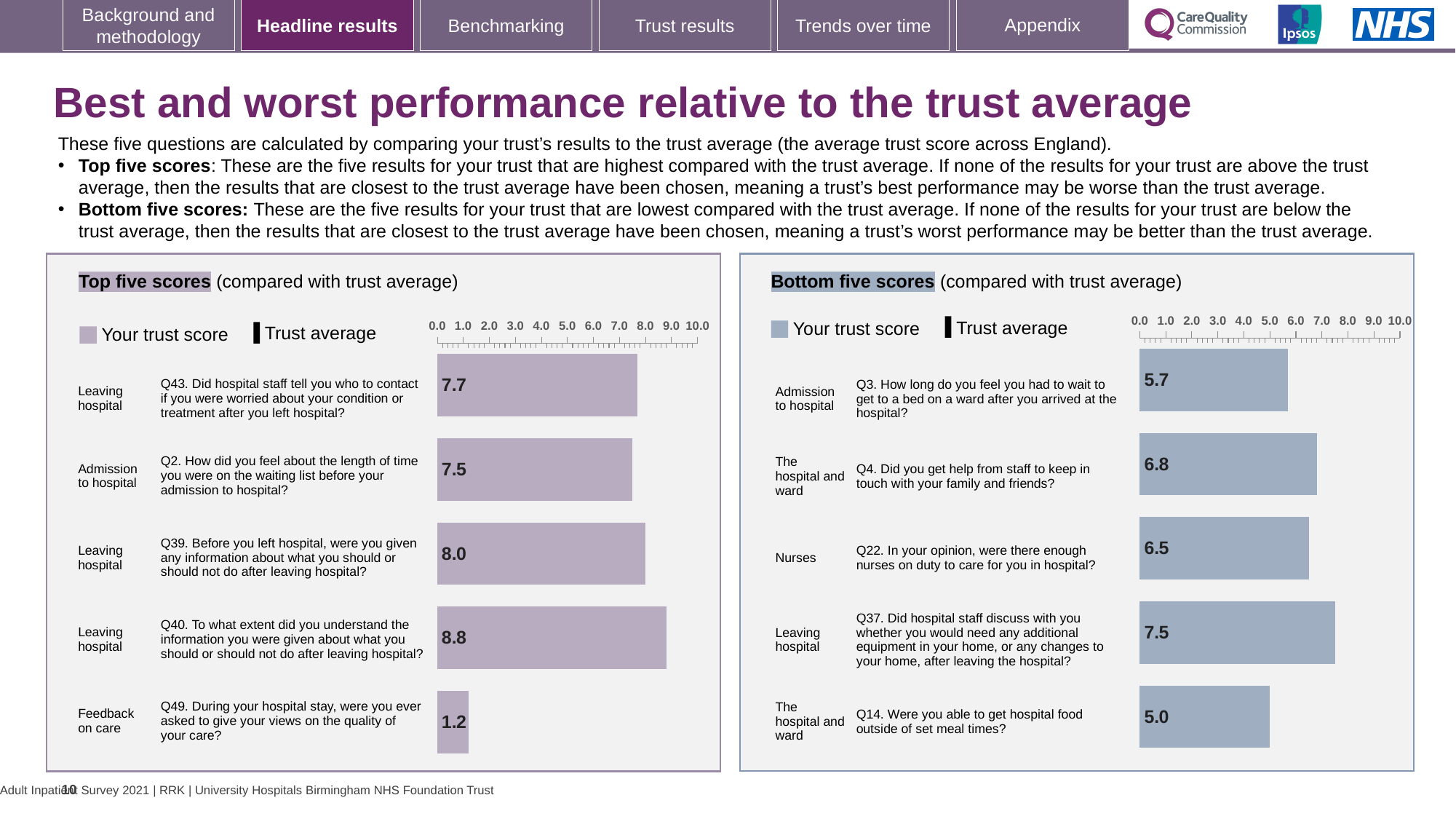
In the Top five scores chart, what is the trust score for Q49 (During your hospital stay, were you ever asked to give your views on the quality of your care)? 1.2 In the Top five scores chart, which question has the lowest trust score? Q49 How many bars are plotted in the Top five scores chart? 5 In the Bottom five scores chart, which question has the highest trust score? Q37 In the Top five scores chart, what is the difference between the trust scores for Q40 and Q2? 1.3 In the Bottom five scores chart, which has the larger trust score, Q3 or Q14? Q3 What kind of chart is the Bottom five scores chart? Bar chart In the Top five scores chart, what is the trust score for Q43 (Did hospital staff tell you who to contact if you were worried about your condition or treatment after you left hospital)? 7.7 In the Bottom five scores chart, which question has the lowest trust score? Q14 In the Top five scores chart, which question has the highest trust score? Q40 In the Bottom five scores chart, what is the trust score for Q3 (How long do you feel you had to wait to get to a bed on a ward after you arrived at the hospital)? 5.7 In the Bottom five scores chart, what is the difference between the trust scores for Q4 and Q22? 0.3